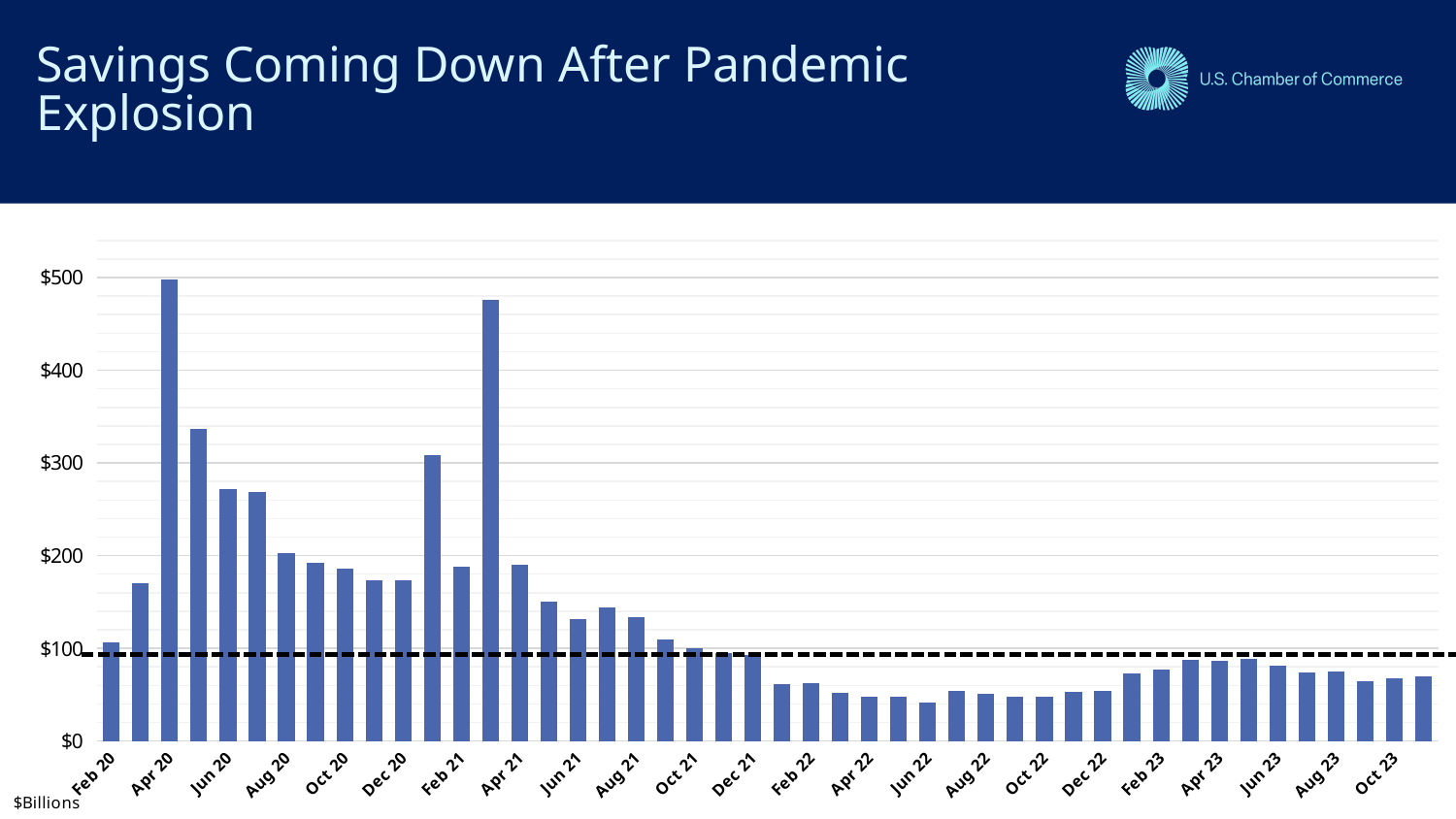
What unit is indicated for the values on the chart? $Billions Is the value for Jun 20 greater or less than $200? greater Is the value for Jun 21 greater or less than $100? greater What is the title of the slide's chart? Savings Coming Down After Pandemic Explosion Do the values generally rise or fall from Apr 21 to Dec 21? fall Is the value for Apr 20 greater or less than $400? greater Which is larger, the value for Apr 20 or the value for Feb 21? Apr 20 Which month has the lowest bar on the chart? Jun 22 What kind of chart is shown on the slide? bar chart Which month has the highest bar on the chart? Apr 20